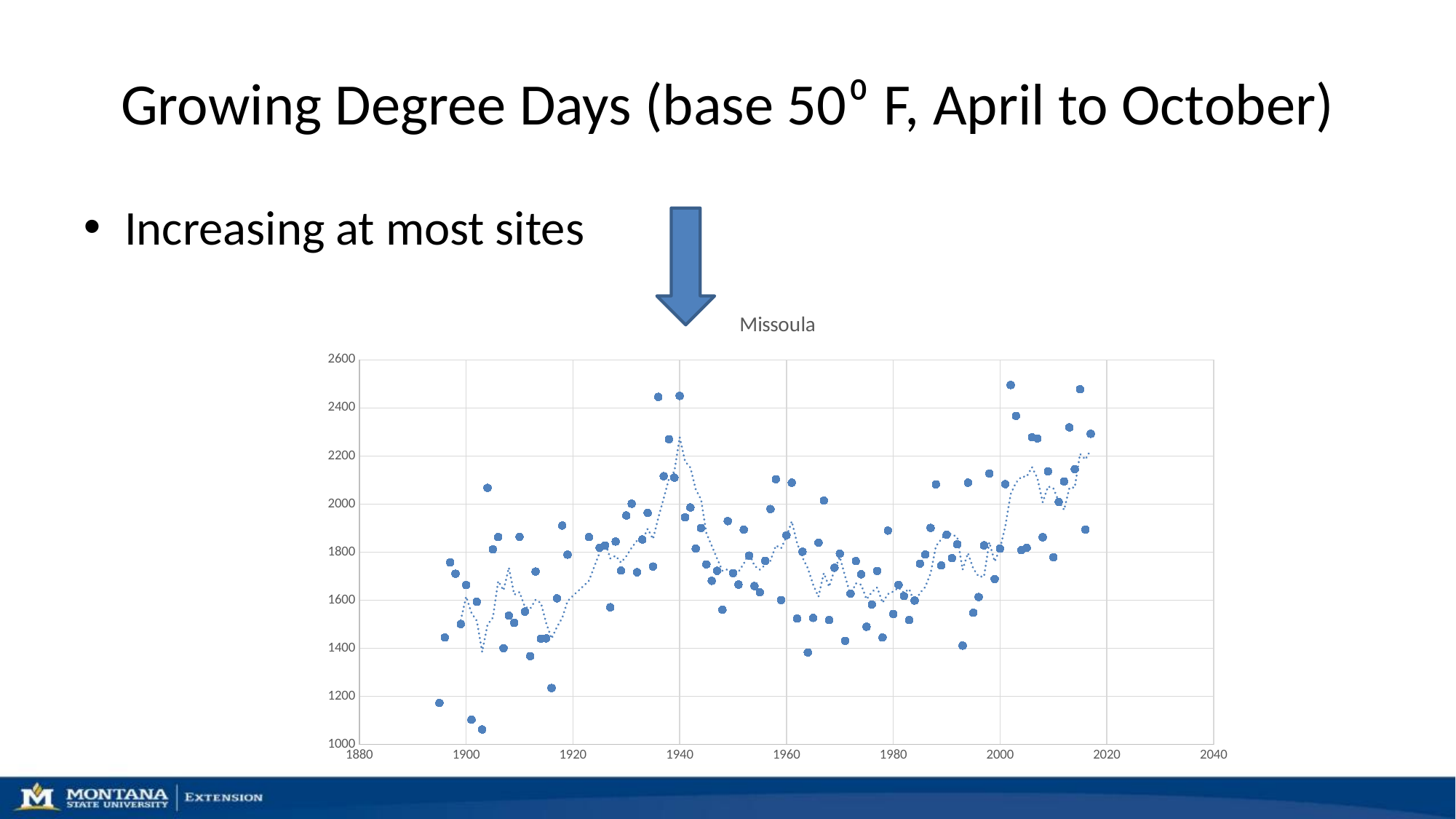
Is the highest plotted point around the year 2002 greater or less than 2400? greater Is the plotted value near the year 2015 greater or less than 2400? greater Is the lowest plotted point, near the year 1903, greater or less than 1200? less What is the title of the chart? Missoula What is the highest value shown on the vertical axis? 2600 Which is larger, the plotted value near 1903 (the lowest point) or the plotted value near 2002 (the highest point)? 2002 What kind of chart is shown on the slide? scatter chart Overall, do the plotted values rise or fall from the earliest years to the most recent years? rise